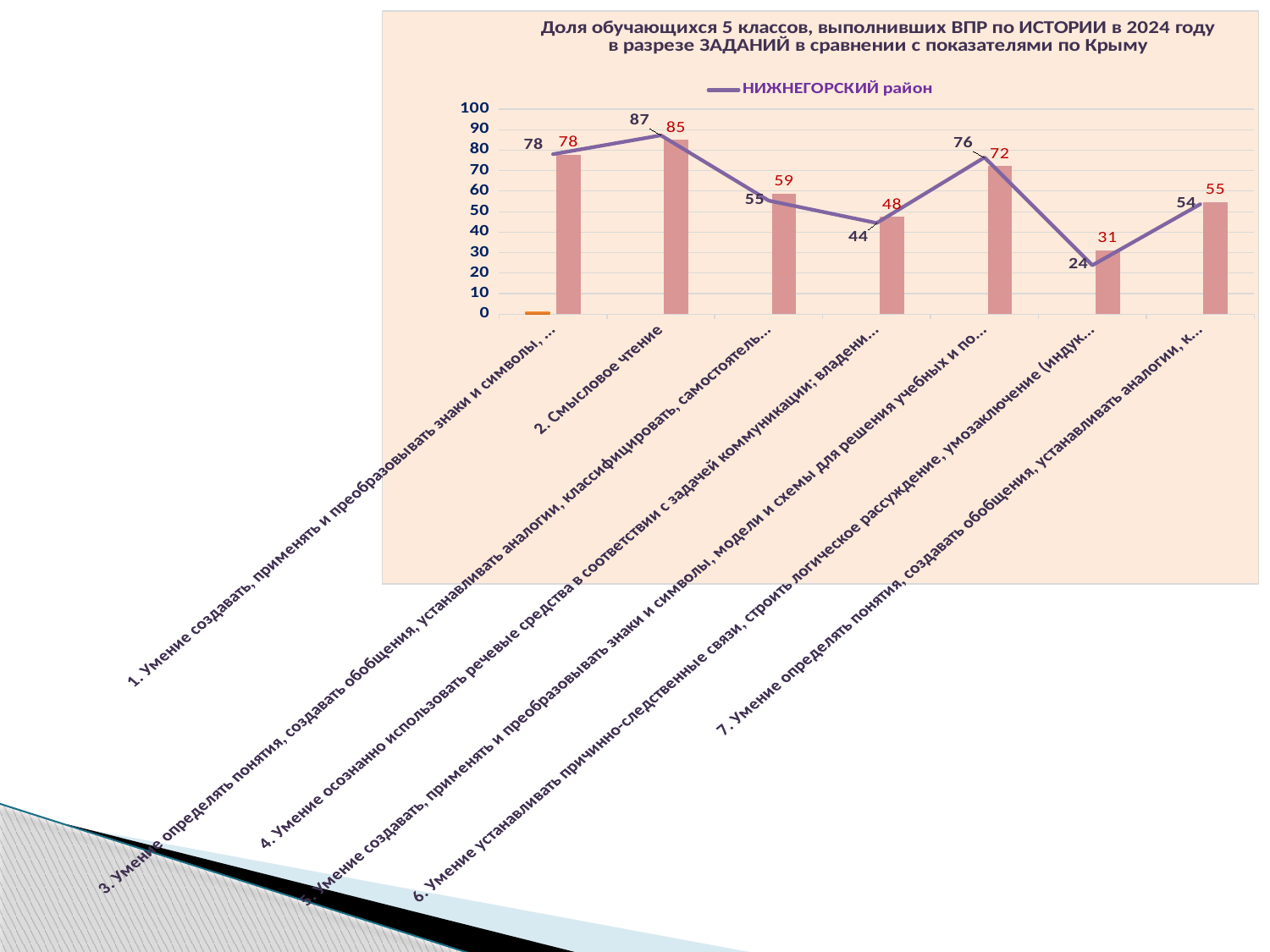
What value does the pink bar show for task 7? 55 What is the difference between the pink bar value and the НИЖНЕГОРСКИЙ район line value for task 3? 4 What value does the НИЖНЕГОРСКИЙ район line show for task 2 (Смысловое чтение)? 87 For which task is the НИЖНЕГОРСКИЙ район line value the highest? 2. Смысловое чтение What kind of chart is this? A combined bar and line chart What value does the НИЖНЕГОРСКИЙ район line show for task 6 (Умение устанавливать причинно-следственные связи...)? 24 Does the НИЖНЕГОРСКИЙ район line rise or fall from task 2 to task 4? Fall For task 4, which is larger: the pink bar value or the НИЖНЕГОРСКИЙ район line value? The pink bar (48) What value does the pink bar show for task 2 (Смысловое чтение)? 85 How many tasks (categories) are shown on the x axis? 7 For which task is the pink bar the lowest? Task 6 (Умение устанавливать причинно-следственные связи...) For which task is the НИЖНЕГОРСКИЙ район line value the lowest? Task 6 (Умение устанавливать причинно-следственные связи...)